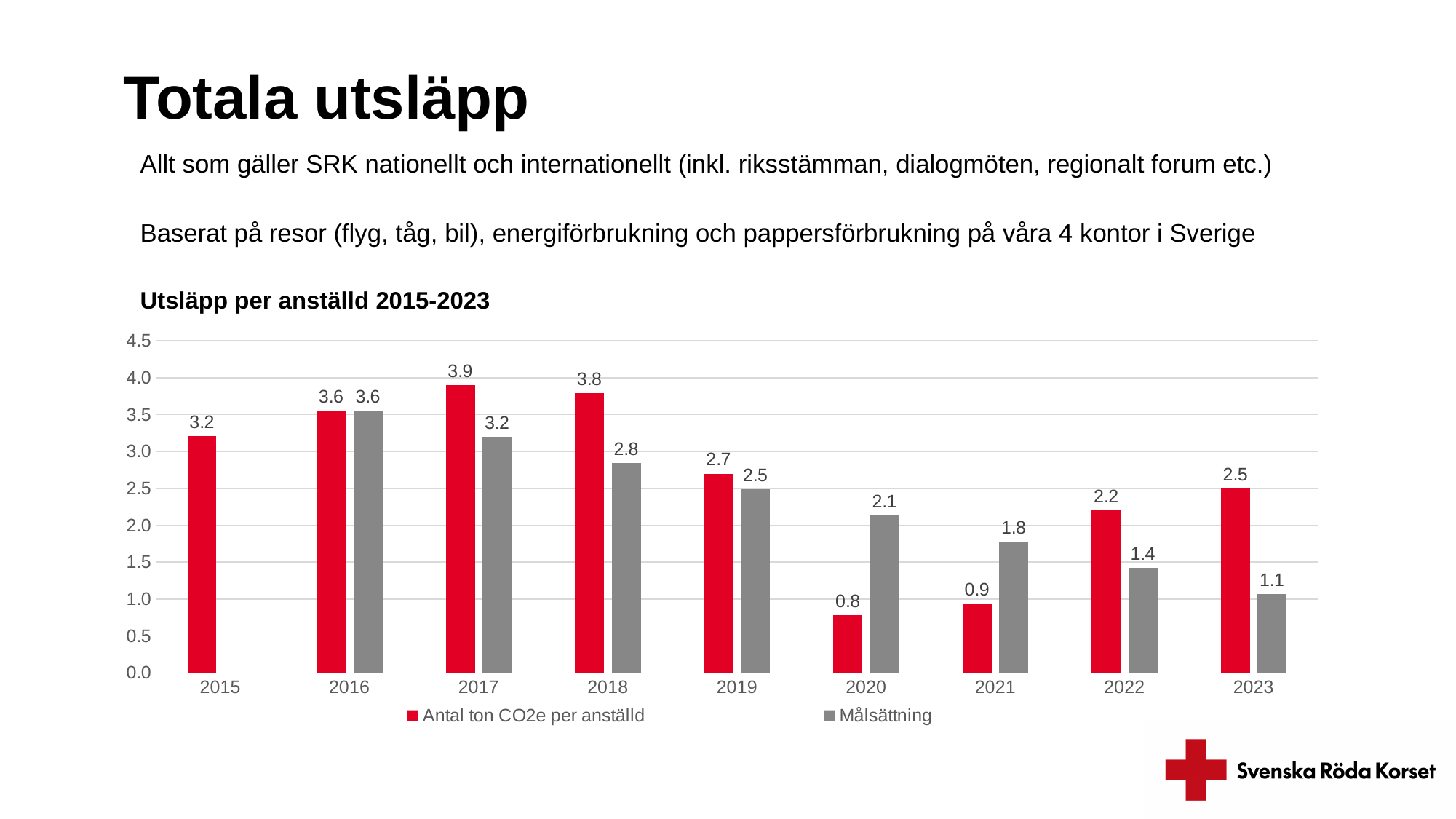
What is the value of "Antal ton CO2e per anställd" for 2017? 3.9 Is the "Målsättning" value for 2020 greater or less than 2.0? greater In 2021, which is larger: "Antal ton CO2e per anställd" or "Målsättning"? Målsättning Which year has the lowest value for "Antal ton CO2e per anställd"? 2020 What is the difference between "Antal ton CO2e per anställd" and "Målsättning" in 2023? 1.4 How many series does the legend list? 2 What kind of chart is shown on the slide? Bar chart Does the "Målsättning" series rise or fall from 2016 to 2023? Fall How many years are shown on the x axis? 9 What is the title of the chart? Utsläpp per anställd 2015-2023 Which year has the highest value for "Antal ton CO2e per anställd"? 2017 What is the "Målsättning" value for 2022? 1.4